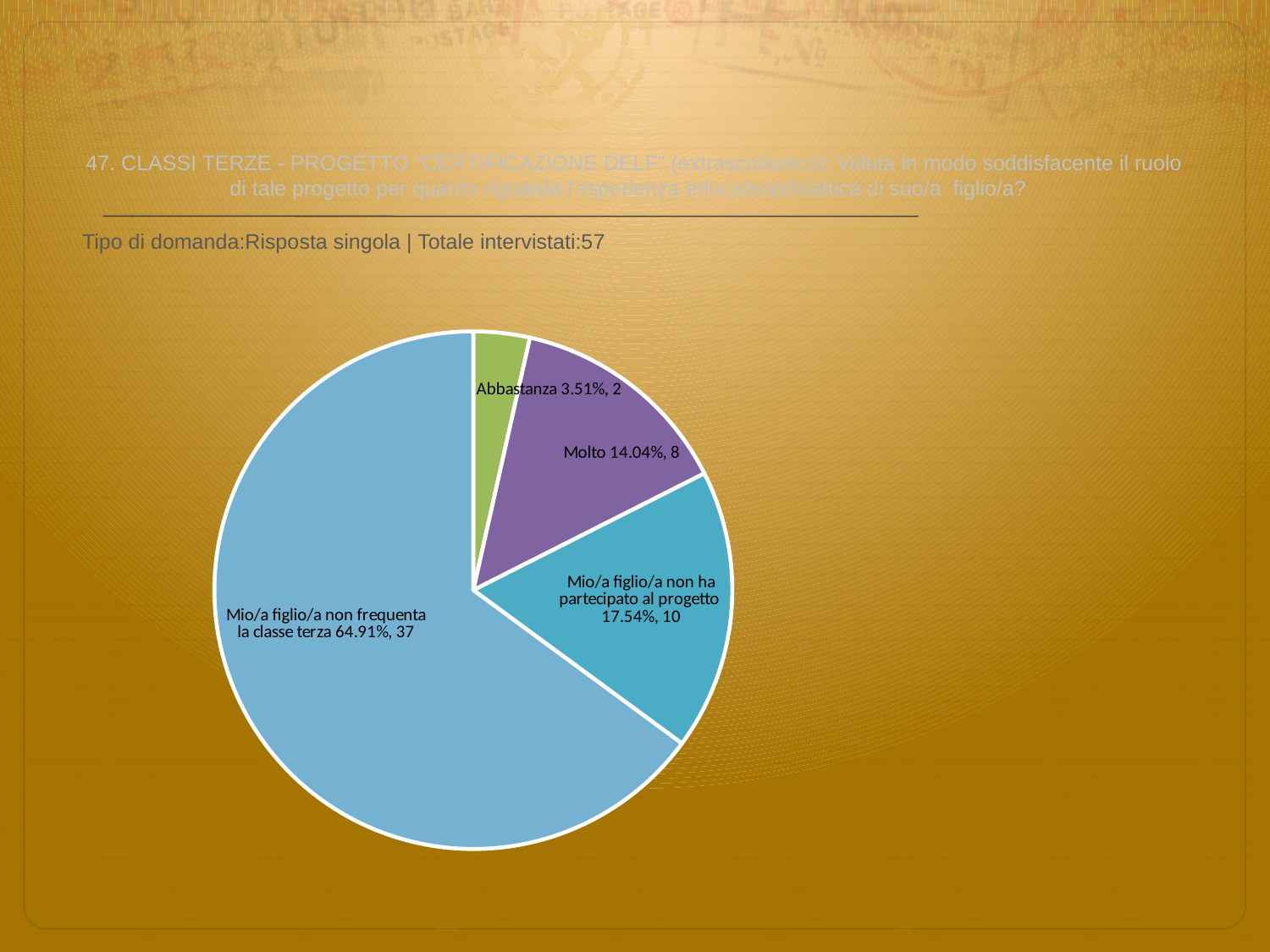
What is the difference in count between 'Mio/a figlio/a non frequenta la classe terza' and 'Mio/a figlio/a non ha partecipato al progetto'? 27 What percentage share does the 'Mio/a figlio/a non frequenta la classe terza' slice have? 64.91% What is the total number of respondents across all slices? 57 What kind of chart is shown on the slide? pie chart Which has more respondents, 'Molto' or 'Abbastanza'? Molto Which category has the smallest slice? Abbastanza How many respondents answered 'Mio/a figlio/a non ha partecipato al progetto'? 10 How many slices does the pie chart have? 4 Which category has the largest slice? Mio/a figlio/a non frequenta la classe terza How many respondents answered 'Abbastanza'? 2 What colour is the 'Molto' slice? purple What percentage share does the 'Molto' slice have? 14.04%